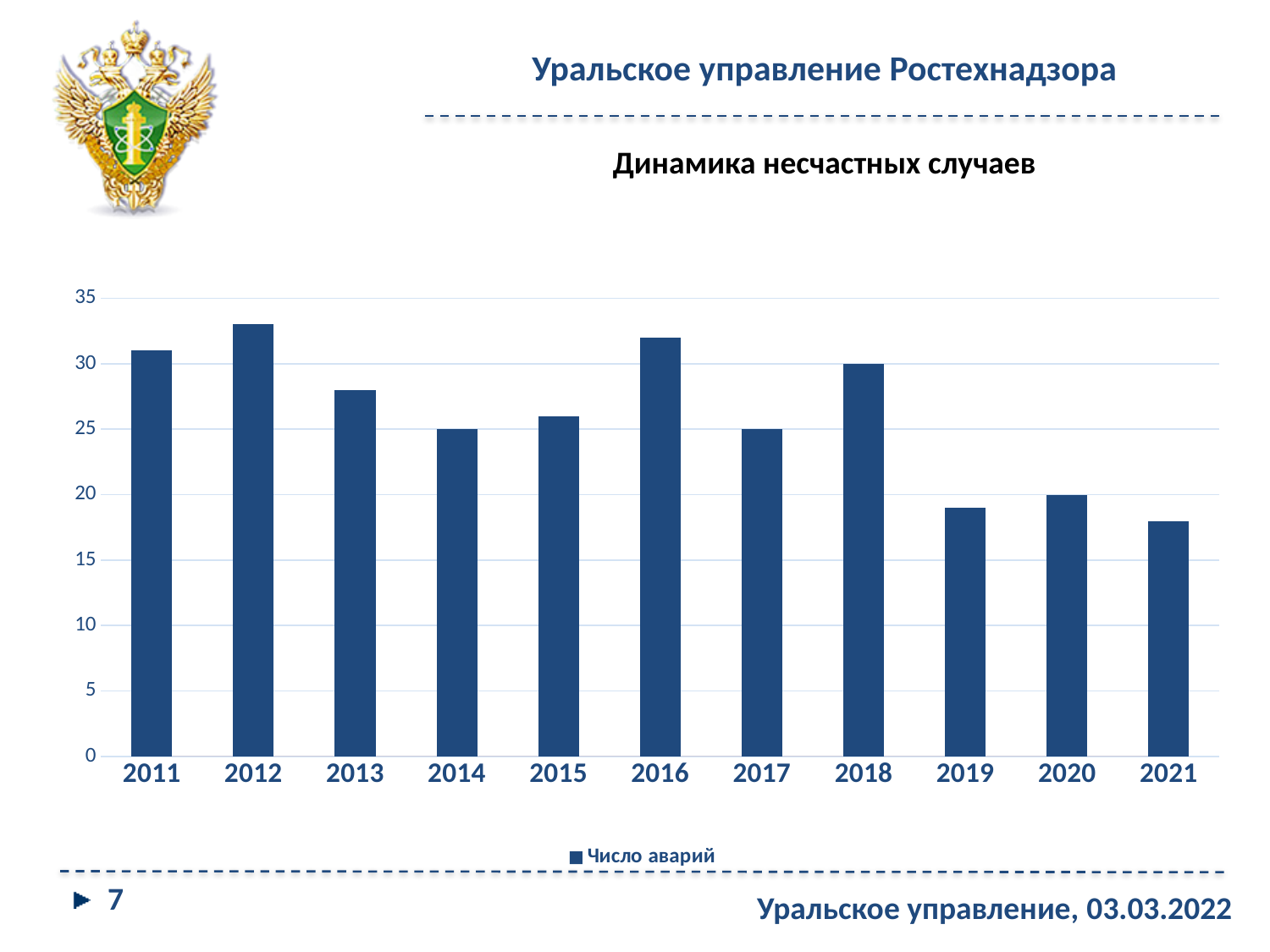
Is the value for 2019 greater or less than 20? less Which is larger, the value for 2011 or the value for 2013? 2011 How many series does the chart legend list? 1 Is the value for 2012 greater or less than 30? greater Which is larger, the value for 2018 or the value for 2019? 2018 Is the value for 2013 greater or less than 30? less Do the values generally rise or fall from 2011 to 2021? fall What is the legend entry of the chart? Число аварий How many years are shown on the x axis of the chart? 11 What is the title of the chart on the slide? Динамика несчастных случаев What kind of chart is shown on the slide? bar chart